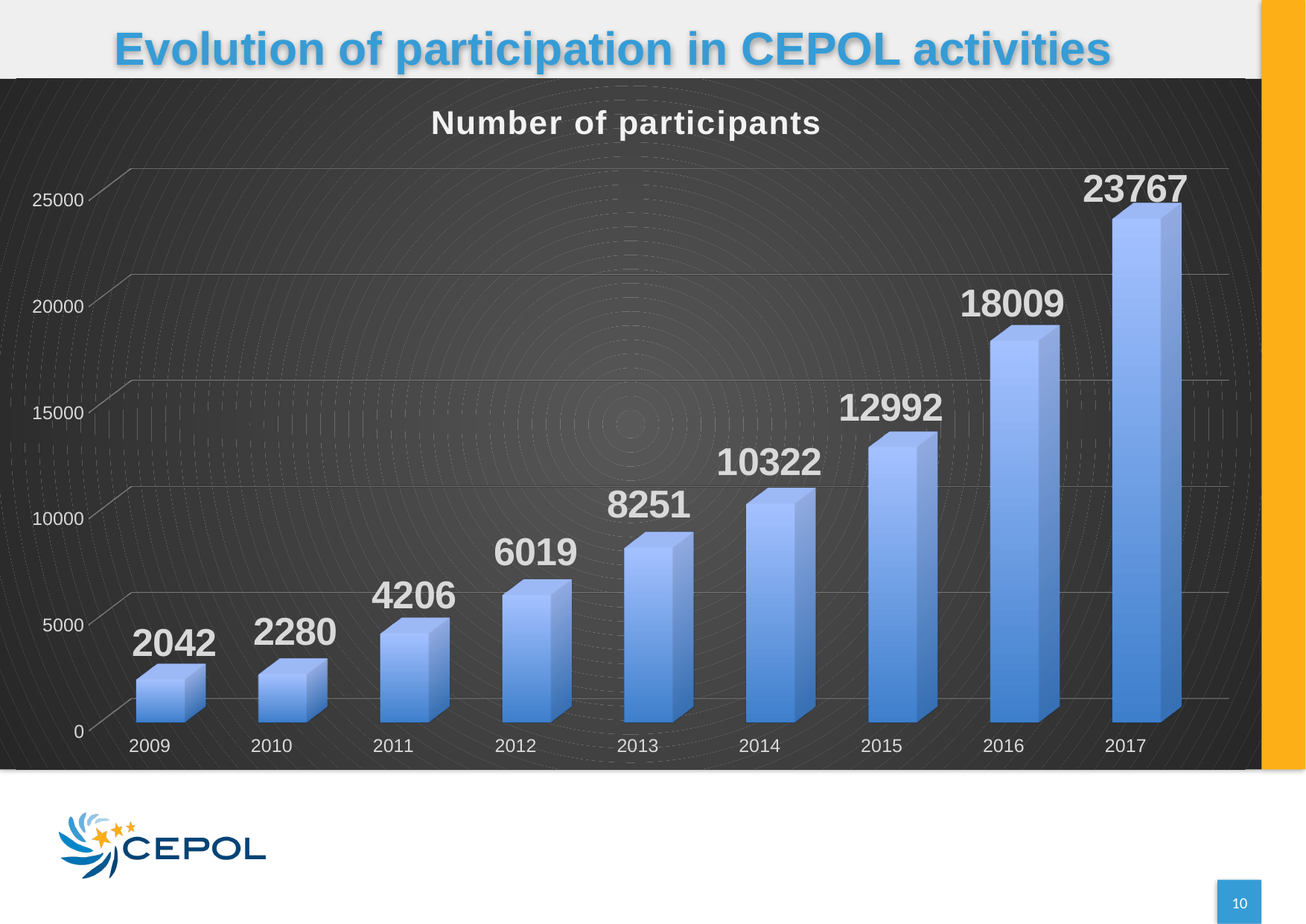
Which year has the lowest number of participants? 2009 Which year has more participants, 2014 or 2015? 2015 What is the number of participants in 2013? 8251 What is the number of participants in 2016? 18009 What kind of chart is shown on the slide? bar chart What is the difference in the number of participants between 2017 and 2016? 5758 Is the number of participants in 2015 greater or less than 10000? greater What is the difference in the number of participants between 2011 and 2010? 1926 What is the number of participants in 2009? 2042 How many years are shown on the x axis? 9 Which year has the highest number of participants? 2017 Do the number of participants rise or fall from 2009 to 2017? rise